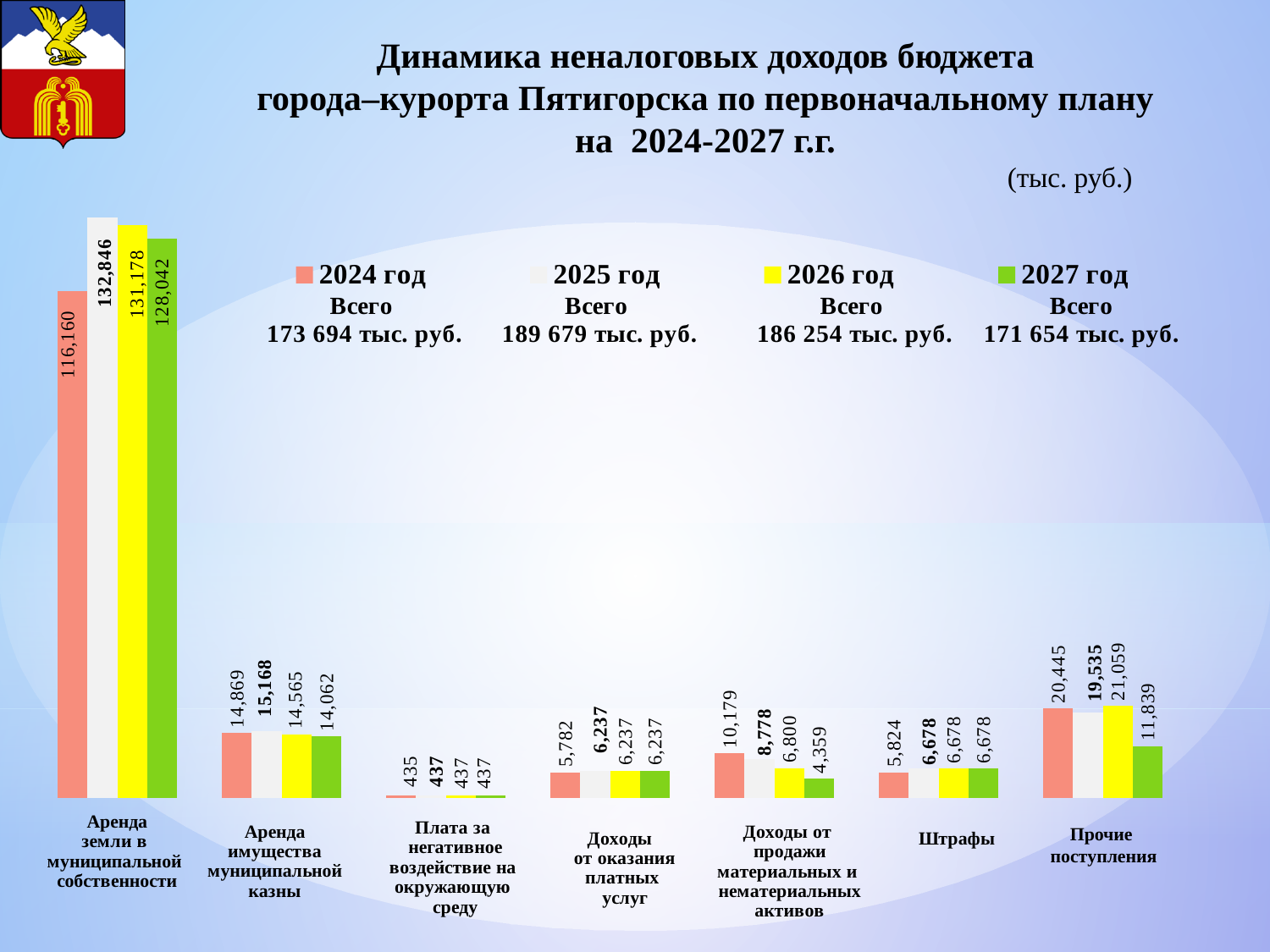
Which is larger in the category Прочие поступления: the value for 2026 год or the value for 2024 год? 2026 год Which year has the lowest value in the category Доходы от продажи материальных и нематериальных активов? 2027 год What is the value for 2024 год in the category Аренда земли в муниципальной собственности? 116,160 What is the value for 2025 год in the category Доходы от продажи материальных и нематериальных активов? 8,778 How many categories are shown on the x axis of the chart? 7 What is the difference between the 2024 год and 2025 год values in the category Штрафы? 854 What kind of chart is shown on the slide? Bar chart What total is shown in the legend for 2026 год? 186 254 тыс. руб. What is the value for 2027 год in the category Прочие поступления? 11,839 Which year has the highest value in the category Аренда земли в муниципальной собственности? 2025 год Do the values for Доходы от продажи материальных и нематериальных активов rise or fall from 2024 год to 2027 год? Fall How many series does the legend list? 4